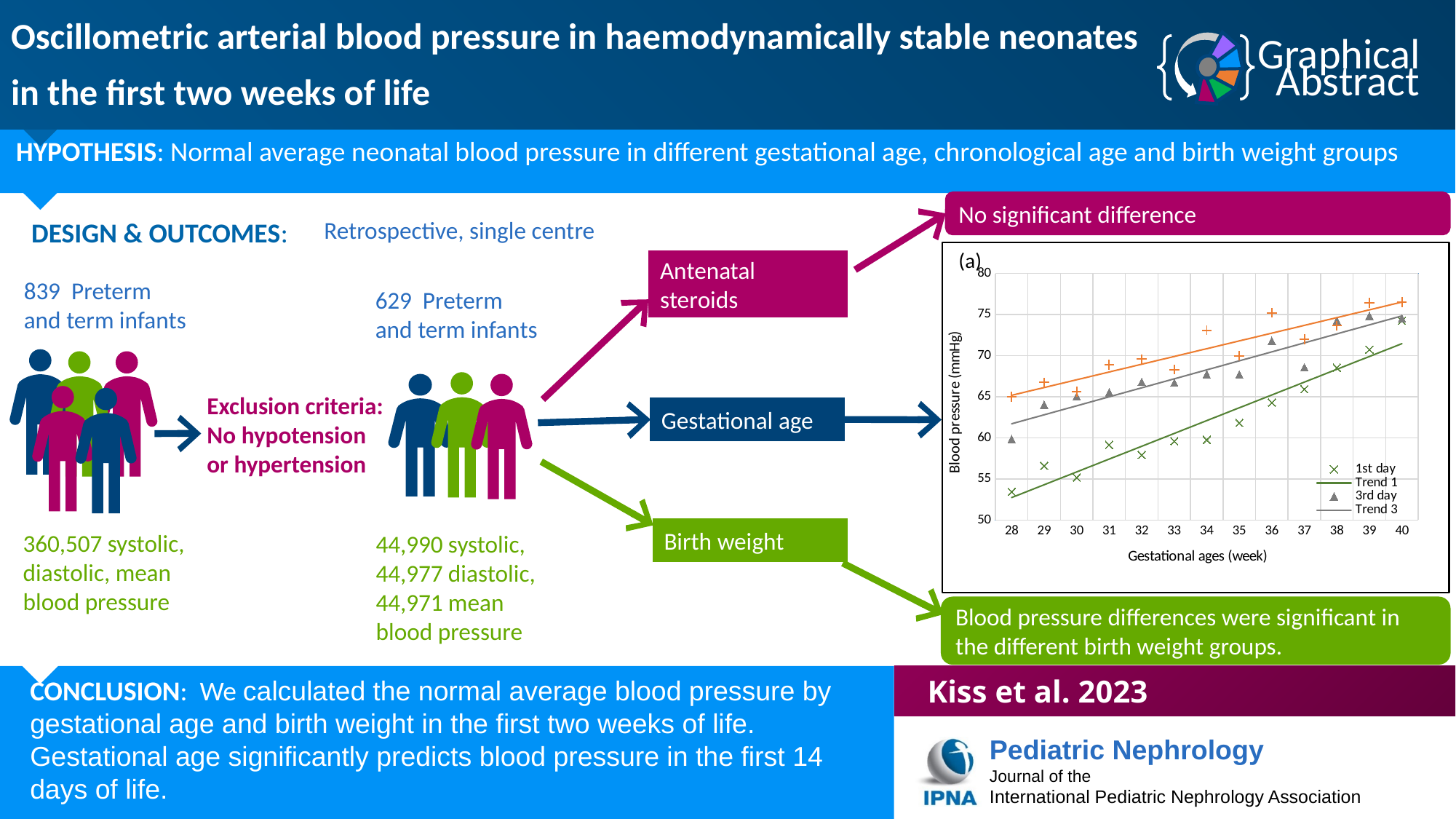
What is the title of the x axis of the chart? Gestational ages (week) At which gestational age is the 1st day blood pressure value lowest? 28 How many gestational age values are marked along the x axis of the chart? 13 Do the 1st day blood pressure values rise or fall as gestational age increases? rise At 28 weeks, which is larger: the 1st day value or the 3rd day value? 3rd day Is the 3rd day blood pressure value at 40 weeks greater or less than 70? greater What kind of chart is shown in panel (a) on the slide? scatter chart Is the 3rd day blood pressure value at 28 weeks greater or less than 65? less What is the title of the y axis of the chart? Blood pressure (mmHg) Is the 1st day blood pressure value at 28 weeks greater or less than 55? less How many entries are visible in the chart's legend? 4